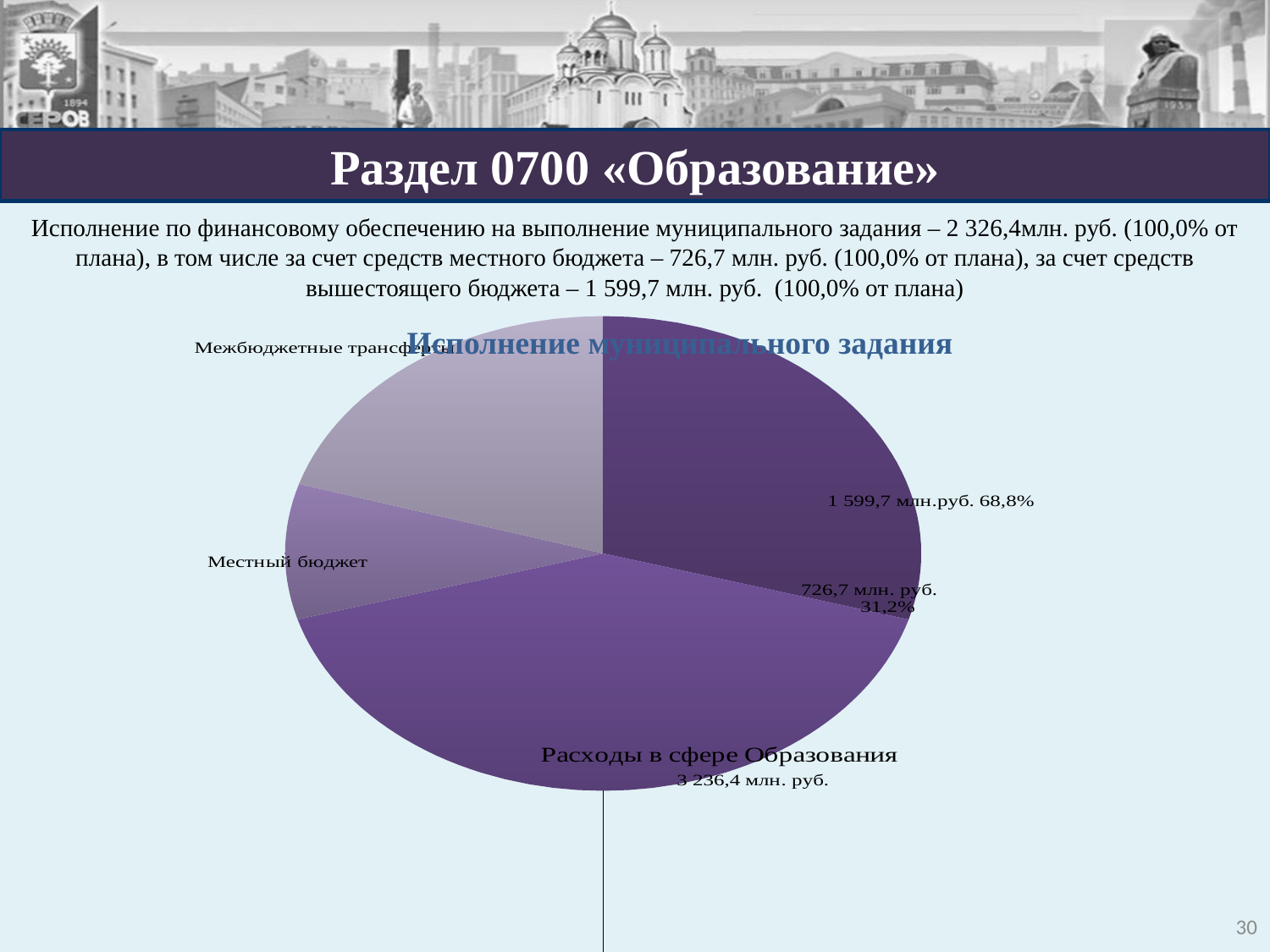
What is the sum of Межбюджетные трансферты and Местный бюджет? 2 326,4 млн. руб. What share of the pie is labelled for Местный бюджет? 31,2% What value is printed for Местный бюджет? 726,7 млн. руб. What is the difference between Межбюджетные трансферты (1 599,7 млн. руб.) and Местный бюджет (726,7 млн. руб.)? 873,0 млн. руб. Which is larger, Межбюджетные трансферты or Местный бюджет? Межбюджетные трансферты What value is printed for Межбюджетные трансферты? 1 599,7 млн.руб. What value is printed for Расходы в сфере Образования? 3 236,4 млн. руб. What is the title of the chart? Исполнение муниципального задания What kind of chart is shown on the slide? pie chart How many slices does the pie chart have? 3 Which slice label is placed at the bottom of the pie chart? Расходы в сфере Образования What share of the pie is labelled for Межбюджетные трансферты? 68,8%